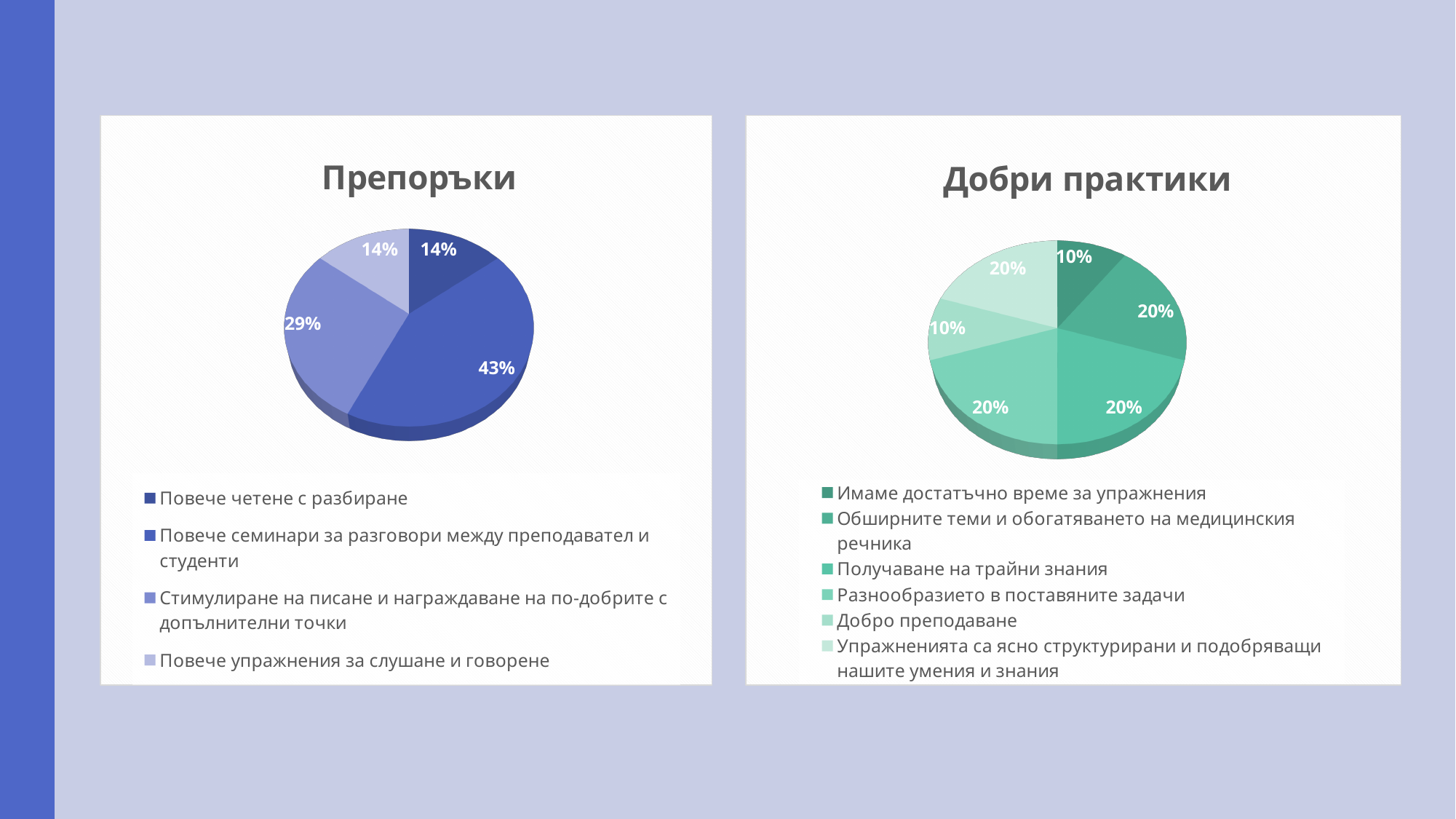
What kind of chart is the chart titled "Препоръки"? Pie chart In the chart titled "Препоръки", how many categories does the legend list? 4 In the chart titled "Добри практики", what share does "Получаване на трайни знания" have? 20% In the chart titled "Препоръки", what share does "Повече семинари за разговори между преподавател и студенти" have? 43% In the chart titled "Препоръки", which category has the largest share? Повече семинари за разговори между преподавател и студенти In the chart titled "Препоръки", what share does "Стимулиране на писане и награждаване на по-добрите с допълнителни точки" have? 29% In the chart titled "Препоръки", what is the difference between the largest slice (43%) and the 29% slice? 14% In the chart titled "Добри практики", what share does "Имаме достатъчно време за упражнения" have? 10% In the chart titled "Добри практики", what share does "Добро преподаване" have? 10% What is the title of the pie chart on the right side of the slide? Добри практики In the chart titled "Добри практики", which is larger: the share for "Добро преподаване" or the share for "Разнообразието в поставяните задачи"? Разнообразието в поставяните задачи In the chart titled "Добри практики", how many categories does the legend list? 6